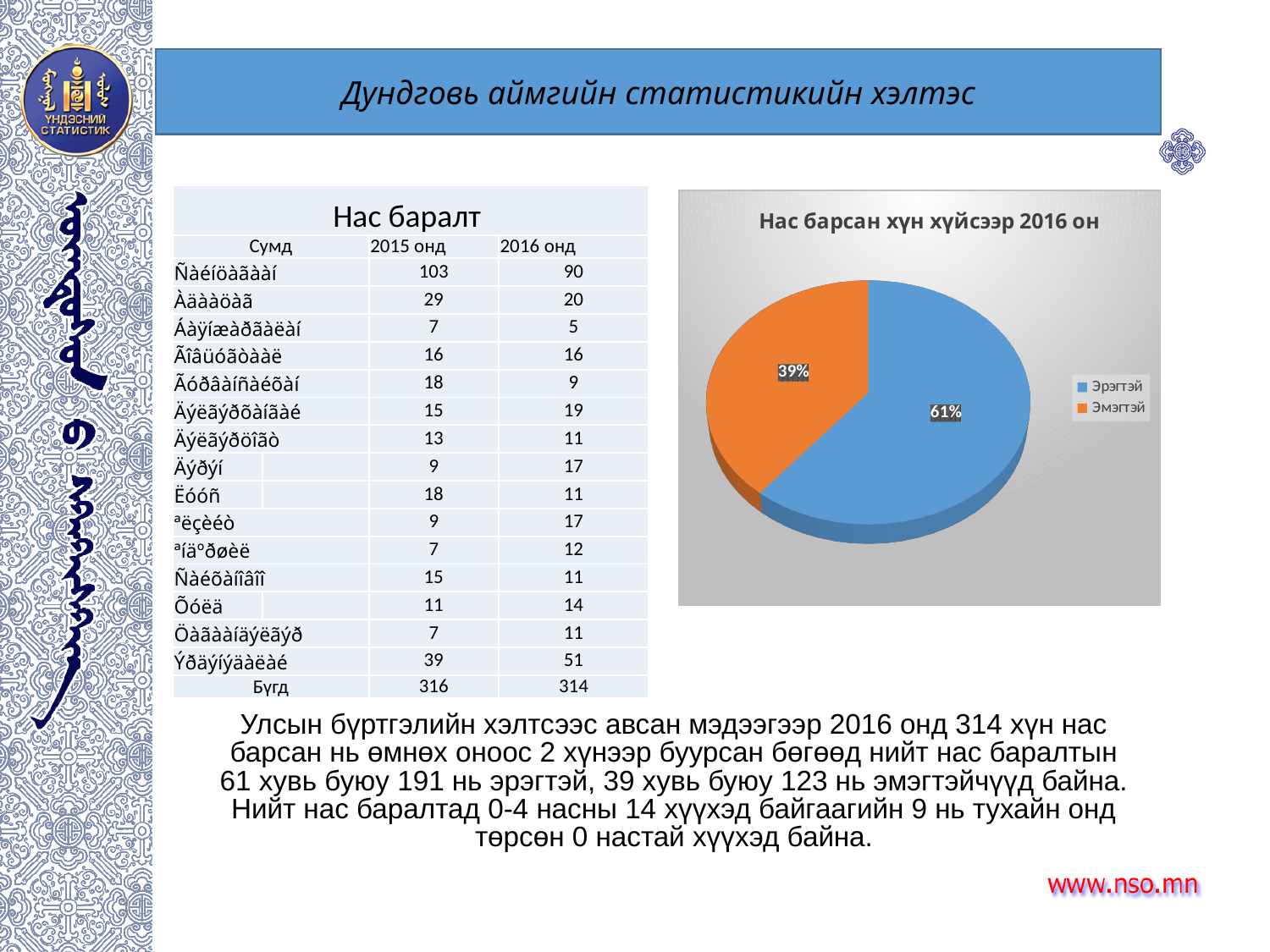
What is the title of the pie chart? Нас барсан хүн хүйсээр 2016 он What is the difference in percentage points between the Эрэгтэй and Эмэгтэй slices? 22 Which slice of the pie chart is the smallest? Эмэгтэй What share of the pie chart does Эрэгтэй represent? 61% How many slices does the pie chart have? 2 Which slice of the pie chart is the largest? Эрэгтэй How many entries does the legend of the pie chart list? 2 What share of the pie chart does Эмэгтэй represent? 39% What colour is the Эмэгтэй slice in the pie chart? orange Which is larger in the pie chart, Эрэгтэй or Эмэгтэй? Эрэгтэй What kind of chart is shown on the slide? pie chart